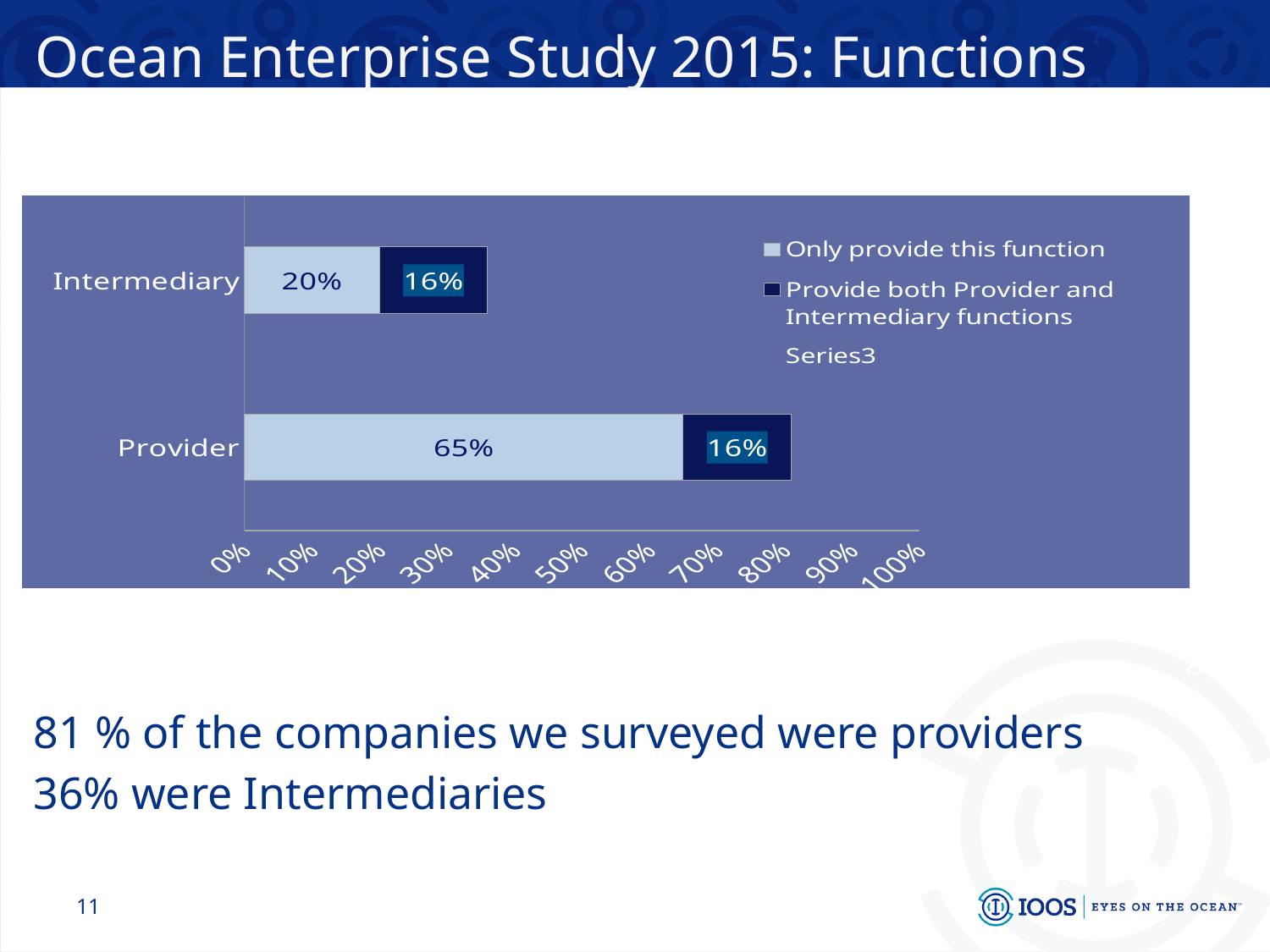
What is the difference between the 'Only provide this function' values for Provider and Intermediary? 45% What is the value of 'Provide both Provider and Intermediary functions' for Provider? 16% What is the total of the stacked bar for Intermediary? 36% What is the value of 'Only provide this function' for Intermediary? 20% What is the name of the third legend entry in the chart? Series3 Which category has the larger 'Only provide this function' value, Provider or Intermediary? Provider What is the value of 'Only provide this function' for Provider? 65% How many series does the chart legend list? 3 How many categories are shown on the vertical axis of the chart? 2 What is the value of 'Provide both Provider and Intermediary functions' for Intermediary? 16% What kind of chart is shown on the slide? Stacked bar chart What is the total of the stacked bar for Provider? 81%